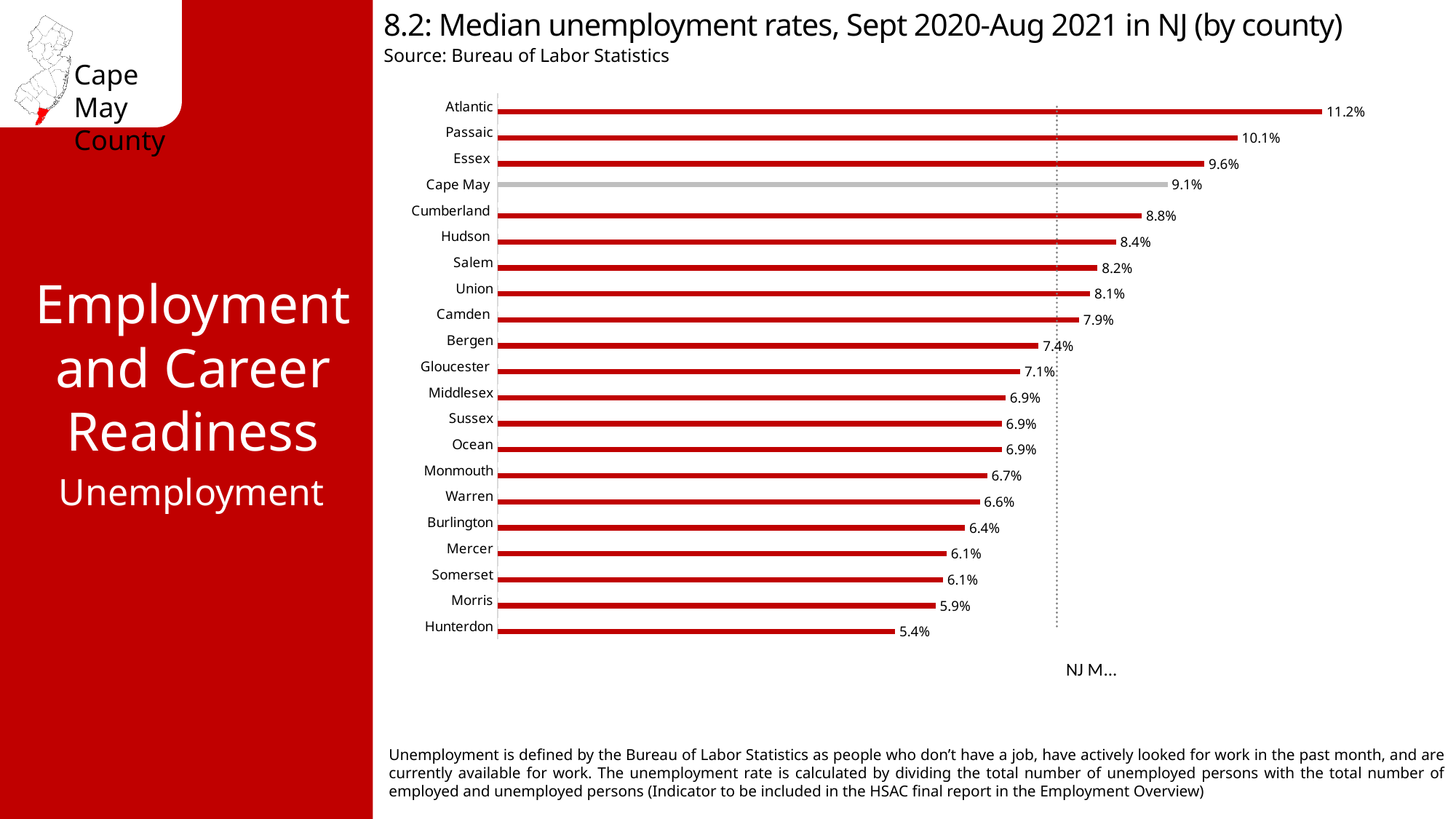
What kind of chart is used to show the median unemployment rates? Bar chart What is the difference between the median unemployment rates of Atlantic and Hunterdon? 5.8 percentage points How many counties are shown on the chart? 21 What is the median unemployment rate shown for Hunterdon? 5.4% Which county has a higher median unemployment rate, Passaic or Essex? Passaic What is the median unemployment rate shown for Atlantic? 11.2% Do the median unemployment rates increase or decrease going from the top bar to the bottom bar? Decrease What is the median unemployment rate shown for Cape May? 9.1% Which county's bar is coloured grey instead of red? Cape May What is the difference between the median unemployment rates of Cape May and Cumberland? 0.3 percentage points Which county has the highest median unemployment rate on the chart? Atlantic Which county has the lowest median unemployment rate on the chart? Hunterdon